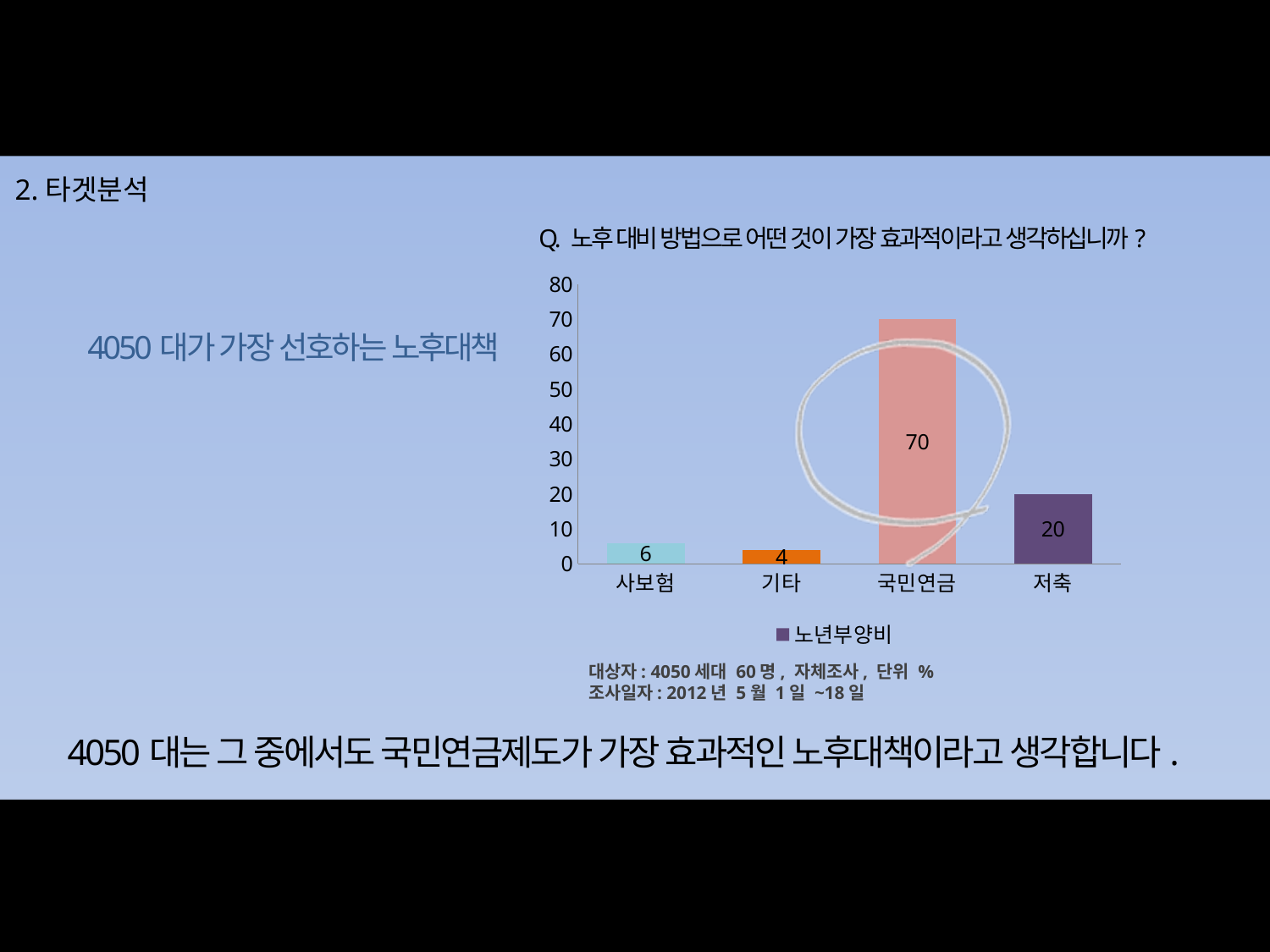
What is the value for 사보험? 6 What is the legend entry shown below the chart? 노년부양비 Which category has the highest value? 국민연금 Which category has the lowest value? 기타 Which is larger, the value for 사보험 or the value for 기타? 사보험 What is the value for 기타? 4 How many categories are shown on the x axis? 4 How many series does the legend list? 1 What is the difference between the values for 국민연금 and 저축? 50 What is the value for 저축? 20 What kind of chart is shown? bar chart What is the value for 국민연금? 70